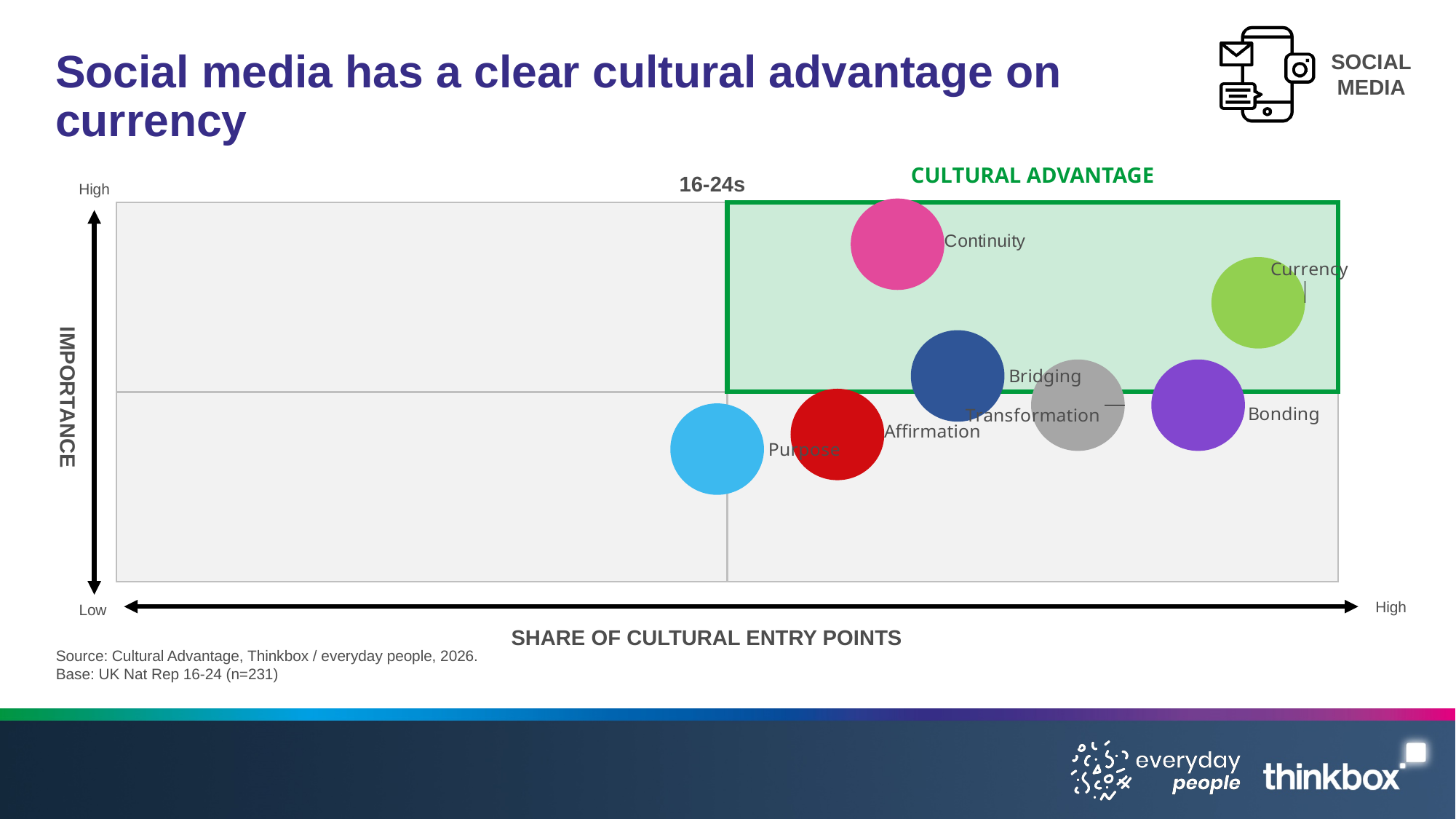
Which bubble has the lowest importance? Purpose Which bubble has the lowest share of cultural entry points? Purpose What is the green highlighted region of the chart labelled? CULTURAL ADVANTAGE What kind of chart is shown on the slide? Bubble chart Which has a higher importance, Continuity or Bonding? Continuity Which has a higher share of cultural entry points, Bonding or Affirmation? Bonding What is the label of the horizontal axis? SHARE OF CULTURAL ENTRY POINTS How many labelled bubbles are plotted on the chart? 7 Which bubble has the highest share of cultural entry points? Currency Which has a higher share of cultural entry points, Currency or Purpose? Currency Which bubble has the highest importance? Continuity